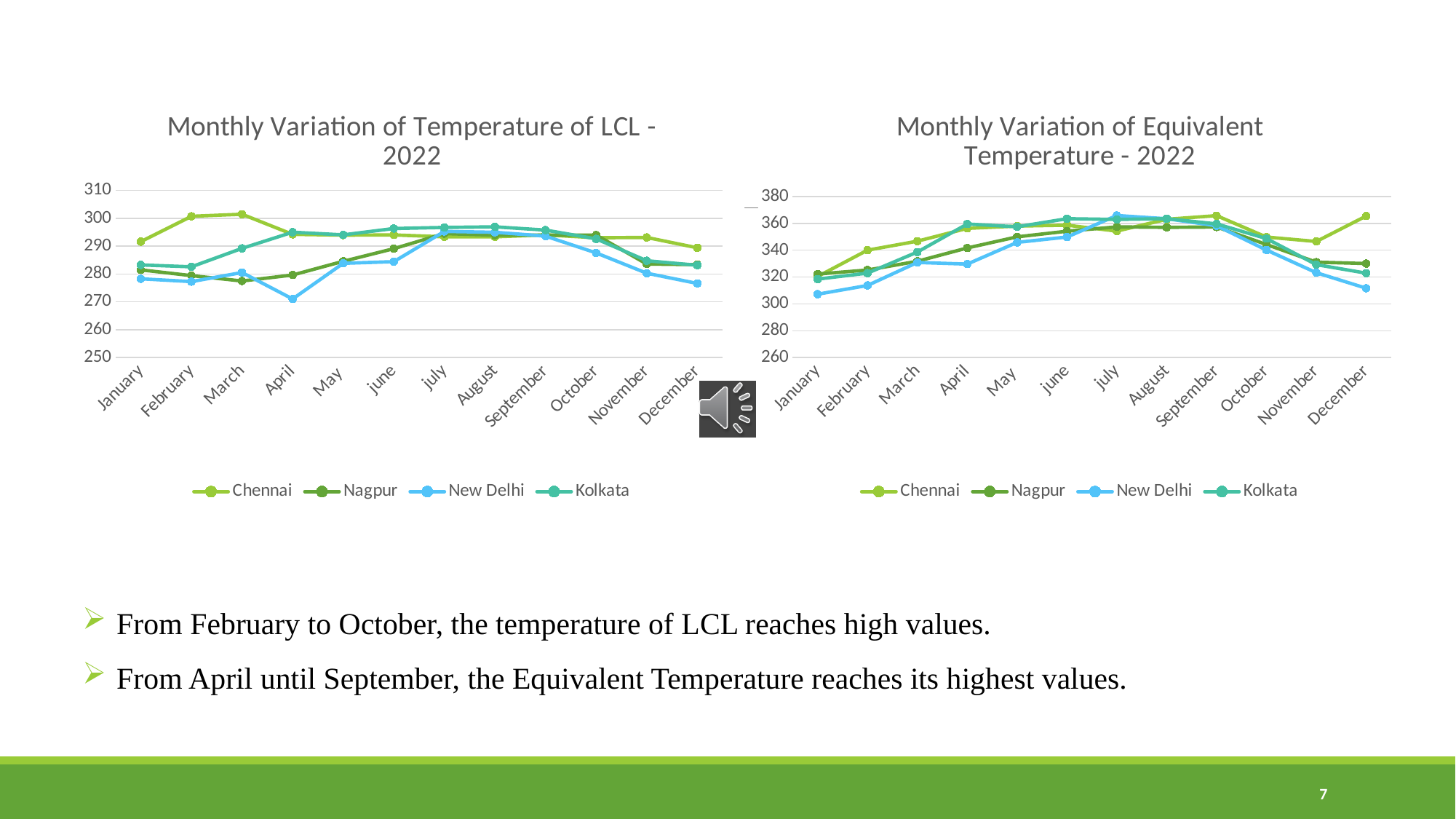
In the 'Monthly Variation of Equivalent Temperature - 2022' chart, is the value for Chennai in December greater or less than 360? greater In the 'Monthly Variation of Temperature of LCL - 2022' chart, which city has the lowest value in April? New Delhi In the 'Monthly Variation of Equivalent Temperature - 2022' chart, which is larger in December, the value for Chennai or the value for New Delhi? Chennai How many months are plotted along the x axis of the 'Monthly Variation of Temperature of LCL - 2022' chart? 12 In the 'Monthly Variation of Temperature of LCL - 2022' chart, is the value for New Delhi in April greater or less than 280? less In the 'Monthly Variation of Equivalent Temperature - 2022' chart, does the New Delhi line rise or fall from September to December? fall In the 'Monthly Variation of Temperature of LCL - 2022' chart, which city has the highest value in March? Chennai In the 'Monthly Variation of Temperature of LCL - 2022' chart, is the value for Chennai in March greater or less than 300? greater In the 'Monthly Variation of Equivalent Temperature - 2022' chart, which city has the lowest value in January? New Delhi How many series does the legend of the 'Monthly Variation of Equivalent Temperature - 2022' chart list? 4 What kind of chart is the 'Monthly Variation of Temperature of LCL - 2022' chart? line chart